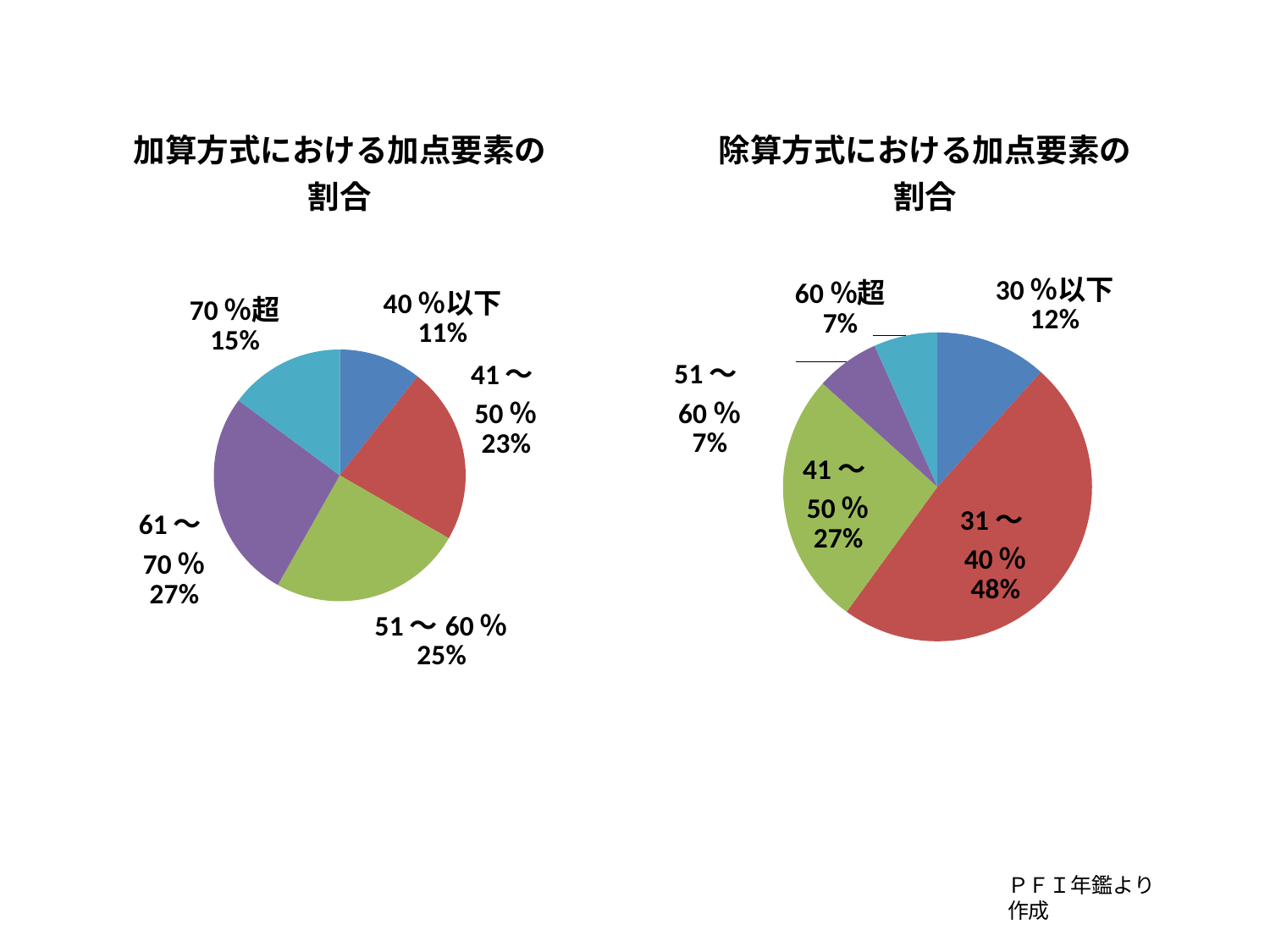
In the right chart (除算方式における加点要素の割合), what share does the 31～40% slice have? 48% In the right chart (除算方式における加点要素の割合), what is the difference between the 31～40% share and the 30%以下 share? 36% How many slices does the right chart (除算方式における加点要素の割合) have? 5 In the left chart (加算方式における加点要素の割合), which is larger: the 41～50% share or the 70%超 share? 41～50% In the left chart (加算方式における加点要素の割合), which category has the smallest share? 40%以下 In the right chart (除算方式における加点要素の割合), which category has the largest share? 31～40% In the right chart (除算方式における加点要素の割合), what share does the 41～50% slice have? 27% In the left chart (加算方式における加点要素の割合), what share does the 61～70% slice have? 27% In the left chart (加算方式における加点要素の割合), what is the difference between the 51～60% share and the 70%超 share? 10% What type of chart is the left chart (加算方式における加点要素の割合)? Pie chart What is the title of the right chart? 除算方式における加点要素の割合 In the left chart (加算方式における加点要素の割合), what share does the 40%以下 slice have? 11%